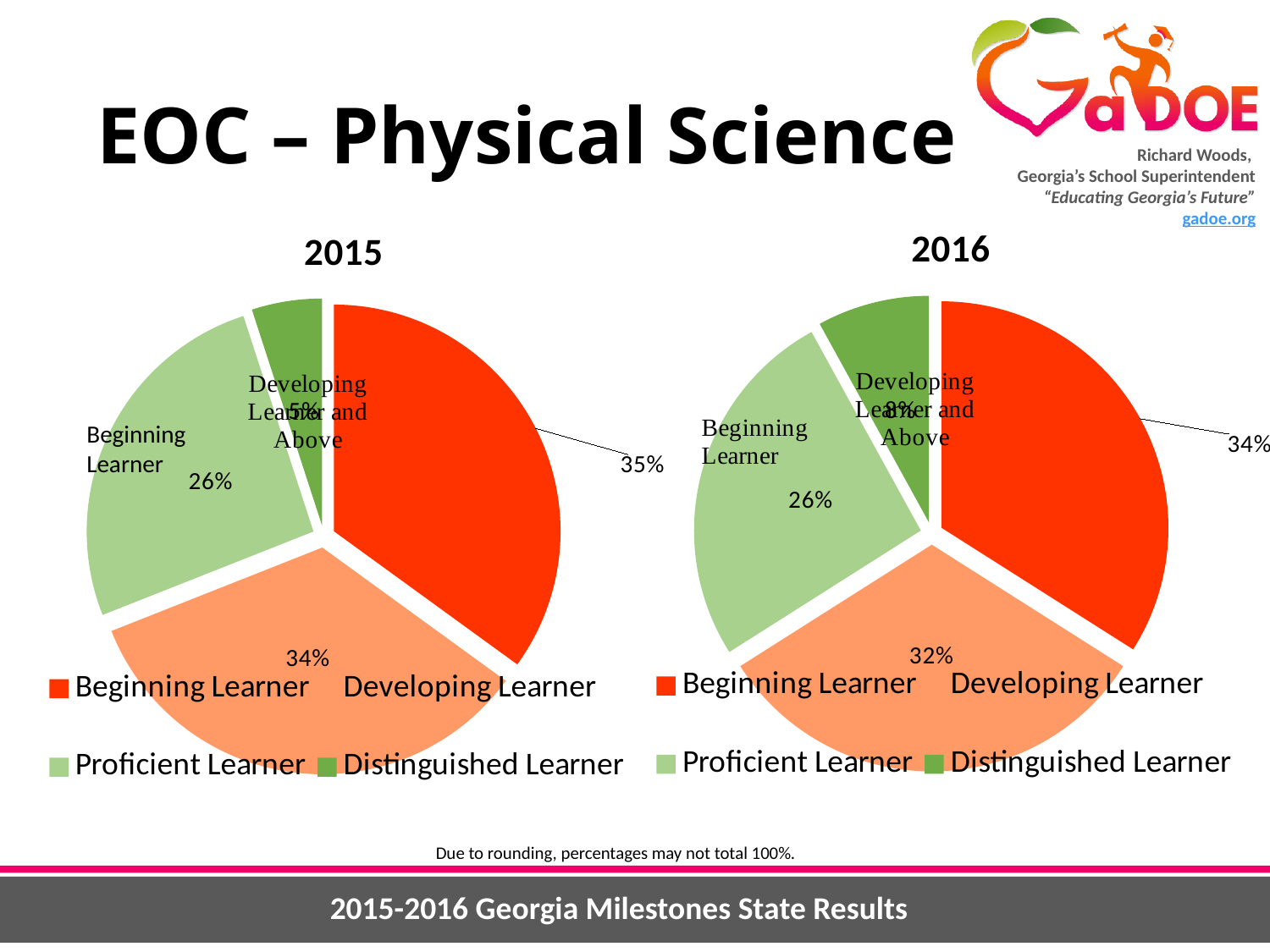
In the 2016 pie chart, what percentage is shown for Proficient Learner? 26% In the 2016 pie chart, what percentage is shown for Beginning Learner? 34% How many categories does the legend of the 2016 pie chart list? 4 In the 2015 pie chart, what percentage is shown for Proficient Learner? 26% In the 2015 pie chart, which category has the largest slice? Beginning Learner In the 2015 pie chart, what is the difference in percentage points between Beginning Learner and Proficient Learner? 9 percentage points In the 2015 pie chart, what percentage is shown for Beginning Learner? 35% In the 2016 pie chart, what percentage is shown for Developing Learner? 32% In the 2016 pie chart, which category has the smallest slice? Distinguished Learner Is the Developing Learner share larger in the 2015 pie chart or the 2016 pie chart? 2015 What type of chart is used for the 2015 and 2016 results on this slide? Pie chart In the 2015 pie chart, what percentage is shown for Developing Learner? 34%